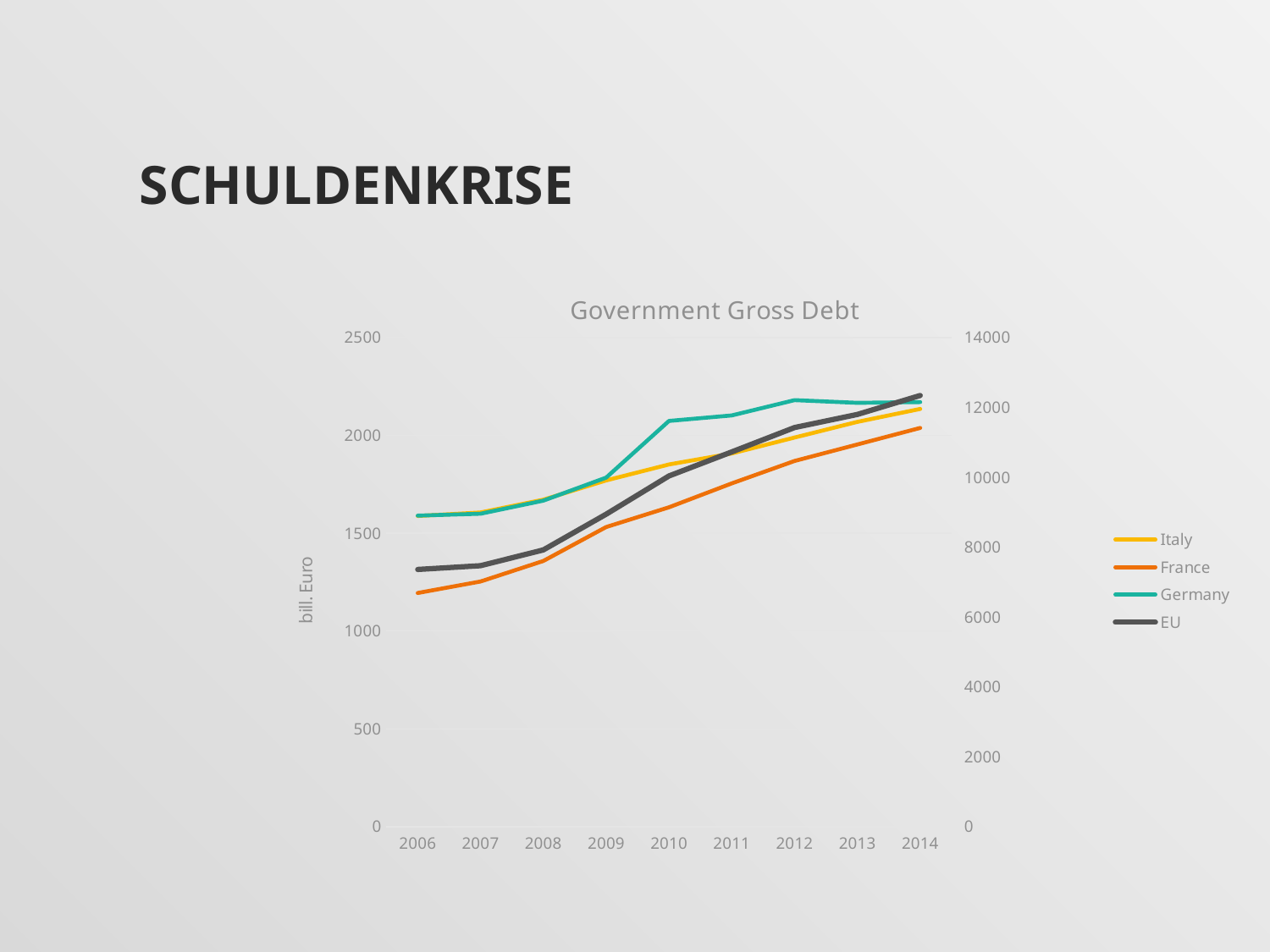
How many years are shown on the x axis? 9 What is the label on the left vertical axis? bill. Euro Does the value for Italy rise or fall from 2006 to 2014? rise In 2012, which is higher, Germany or France? Germany Is the value for France in 2008 greater or less than 1500? less What is the title of the chart? Government Gross Debt Is the value for Italy in 2006 greater or less than 1500? greater Among Italy, France and Germany, which has the lowest value in 2006? France Is the value for Germany in 2014 greater or less than 2000? greater What kind of chart is shown on the slide? line chart How many series does the legend list? 4